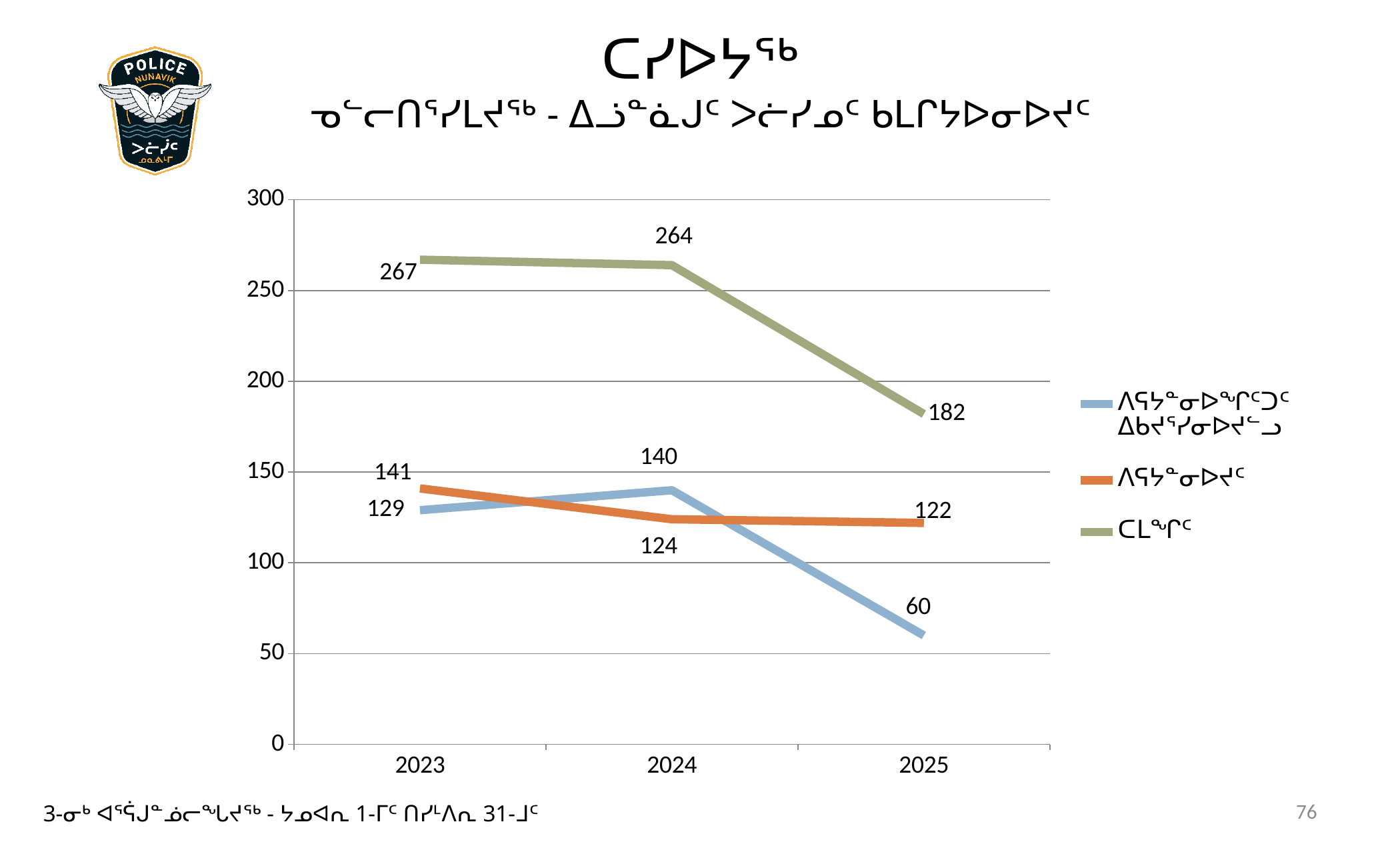
How many series does the legend list? 3 What type of chart is shown on the slide? line chart In which year does the blue line reach its lowest value? 2025 In which year does the green line reach its highest value? 2023 By how much did the green line's value decrease from 2023 to 2025? 85 Does the green line rise or fall from 2023 to 2025? fall What is the value of the orange line in 2023? 141 What is the difference between the blue line's values in 2024 and 2025? 80 How many years are shown on the x axis? 3 What is the value of the green line in 2025? 182 In 2023, which line has the larger value, the blue line or the orange line? orange line What is the value of the blue line in 2024? 140